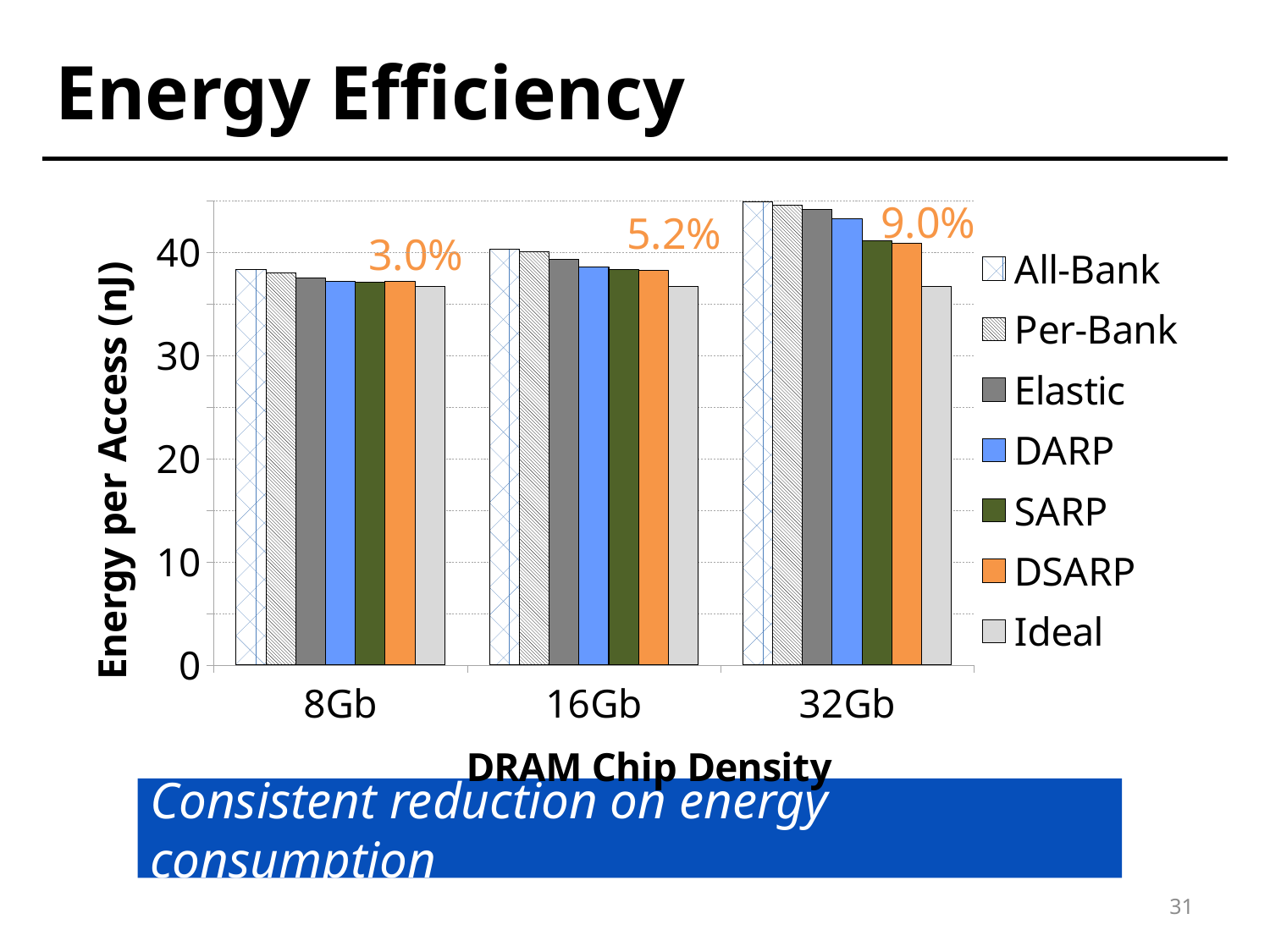
What kind of chart is shown on the slide? bar chart Which is larger: the All-Bank value at 32Gb or the All-Bank value at 8Gb? All-Bank at 32Gb Do the All-Bank values rise or fall as DRAM chip density increases from 8Gb to 32Gb? rise Is the Per-Bank value at 32Gb greater or less than 40? greater At which DRAM chip density is the All-Bank value highest? 32Gb Is the All-Bank value at 32Gb greater or less than 40? greater What percentage is annotated above the 32Gb group of bars? 9.0% How many series does the legend list? 7 Is the Ideal value at 32Gb greater or less than 40? less How many DRAM chip density categories are shown on the x axis? 3 Which series has the lowest value in the 32Gb group? Ideal